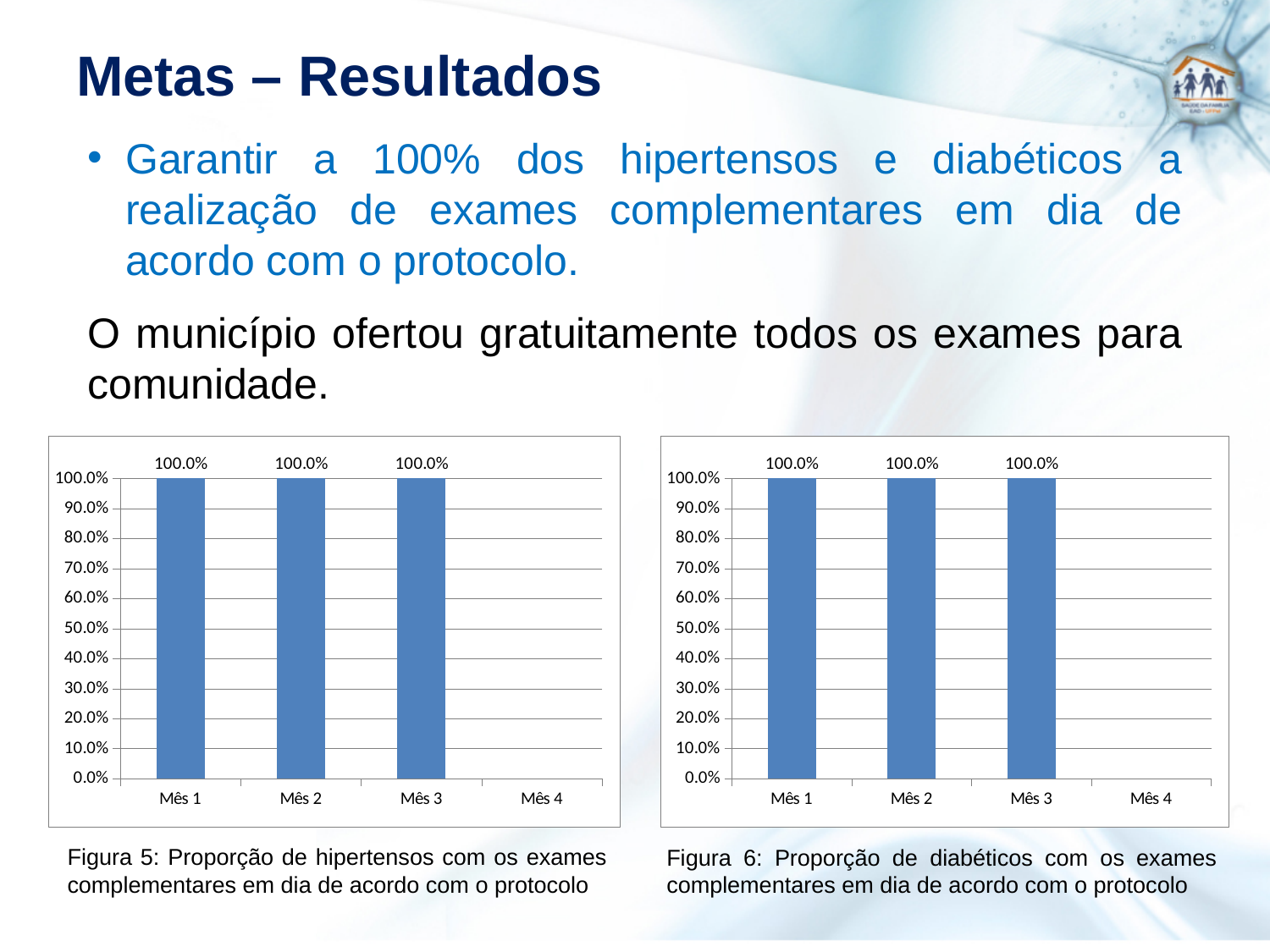
In the right chart (Figura 6), is the value for Mês 1 greater or less than 50.0%? greater How many bars are plotted in the right chart (Figura 6)? 3 In the left chart (Figura 5), what is the difference between the values for Mês 1 and Mês 2? 0.0% In the right chart (Figura 6), what is the value for Mês 2? 100.0% What kind of chart is the left chart (Figura 5)? Bar chart What is the highest tick value shown on the y axis of the right chart (Figura 6)? 100.0% Which category in the left chart (Figura 5) has no bar plotted? Mês 4 In the left chart (Figura 5), what is the value for Mês 3? 100.0% How many categories are shown on the x axis of the left chart (Figura 5)? 4 In the right chart (Figura 6), do the values rise, fall or stay the same from Mês 1 to Mês 3? Stay the same In the left chart (Figura 5), what is the value for Mês 1? 100.0% In the right chart (Figura 6), what is the value for Mês 3? 100.0%